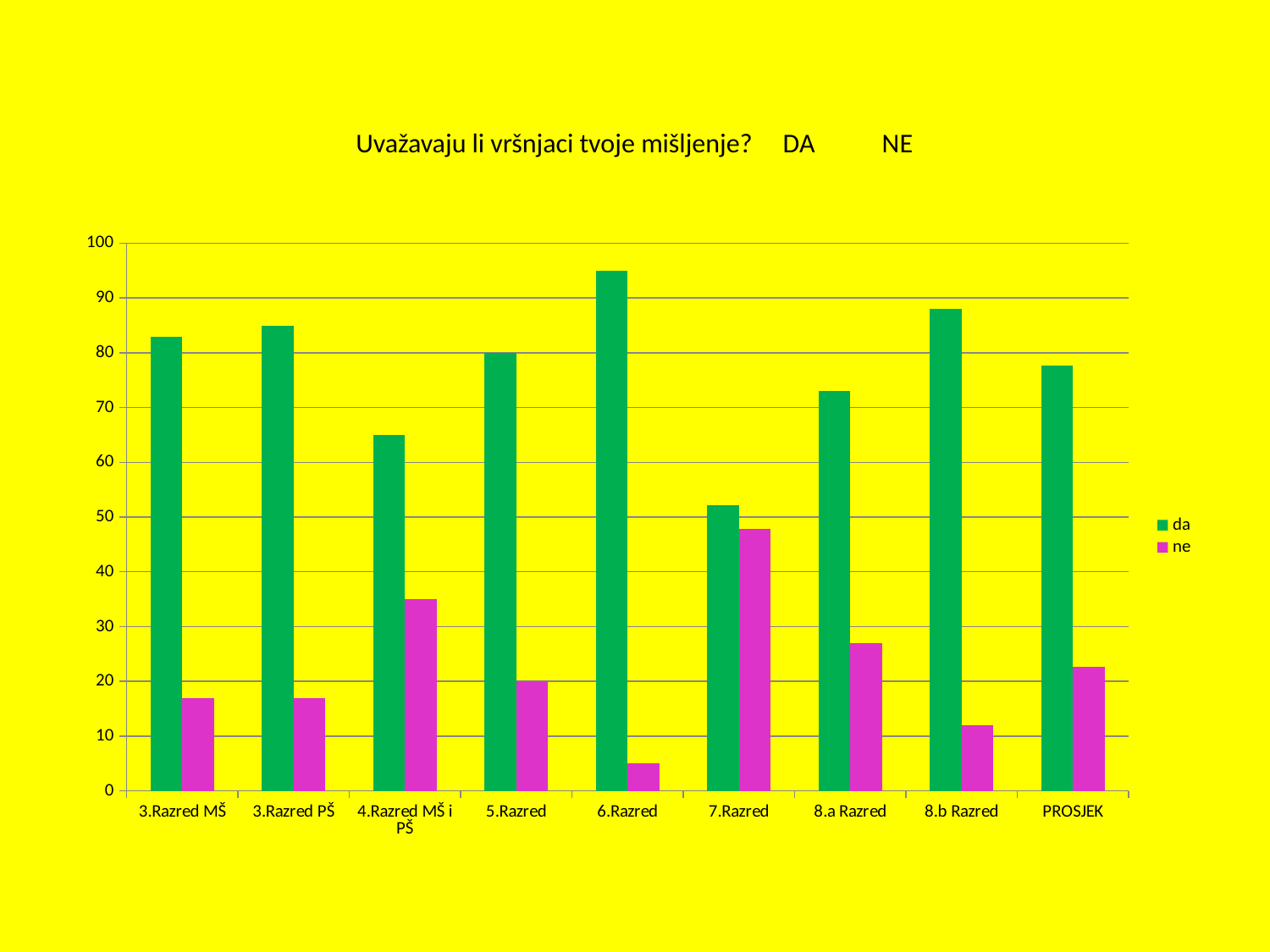
Which category has the lowest value for the 'da' series? 7.Razred How many categories are shown along the x axis? 9 Which category has the lowest value for the 'ne' series? 6.Razred Is the 'ne' value for 8.b Razred greater or less than 20? less Which is larger: the 'da' value for 8.b Razred or the 'da' value for 8.a Razred? 8.b Razred Is the 'da' value for 6.Razred greater or less than 90? greater How many series does the legend list? 2 Which category has the highest value for the 'da' series? 6.Razred Is the 'ne' value for 4.Razred MŠ i PŠ greater or less than 30? greater What are the two entries listed in the legend? da, ne Which category has the highest value for the 'ne' series? 7.Razred What kind of chart is shown on the slide? bar chart